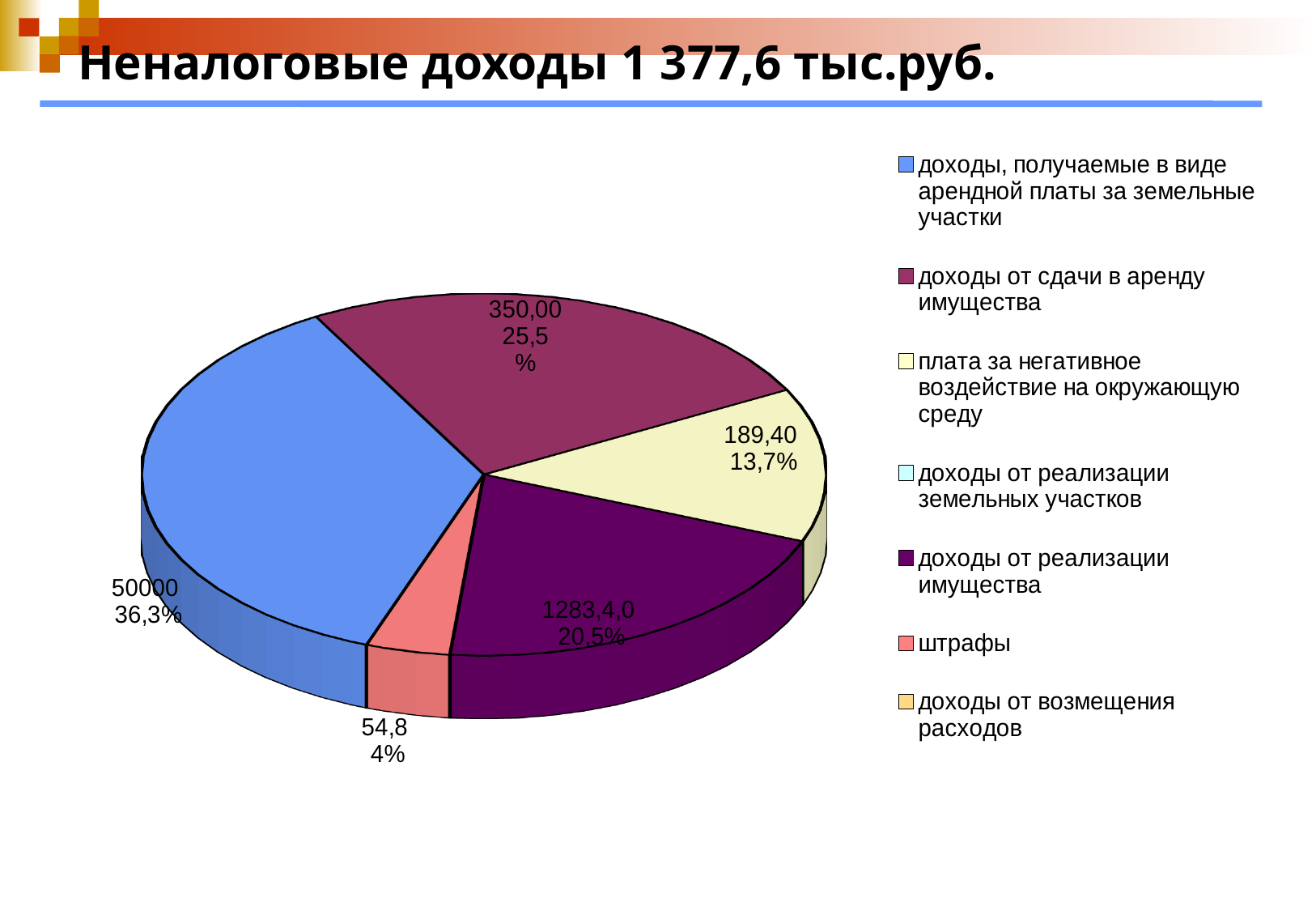
What share of the pie is labelled for 'доходы от сдачи в аренду имущества'? 25,5% What is the title of the chart on the slide? Неналоговые доходы 1 377,6 тыс.руб. What kind of chart is shown on the slide? pie chart Which slice is larger: 'доходы от сдачи в аренду имущества' or 'доходы от реализации имущества'? доходы от сдачи в аренду имущества What value is printed on the slice for 'плата за негативное воздействие на окружающую среду'? 189,40 What value is printed on the slice for 'штрафы'? 54,8 What share of the pie is labelled for 'штрафы'? 4% Which category has the largest slice of the pie? доходы, получаемые в виде арендной платы за земельные участки What share of the pie is labelled for 'доходы от реализации имущества'? 20,5% How many entries does the chart's legend list? 7